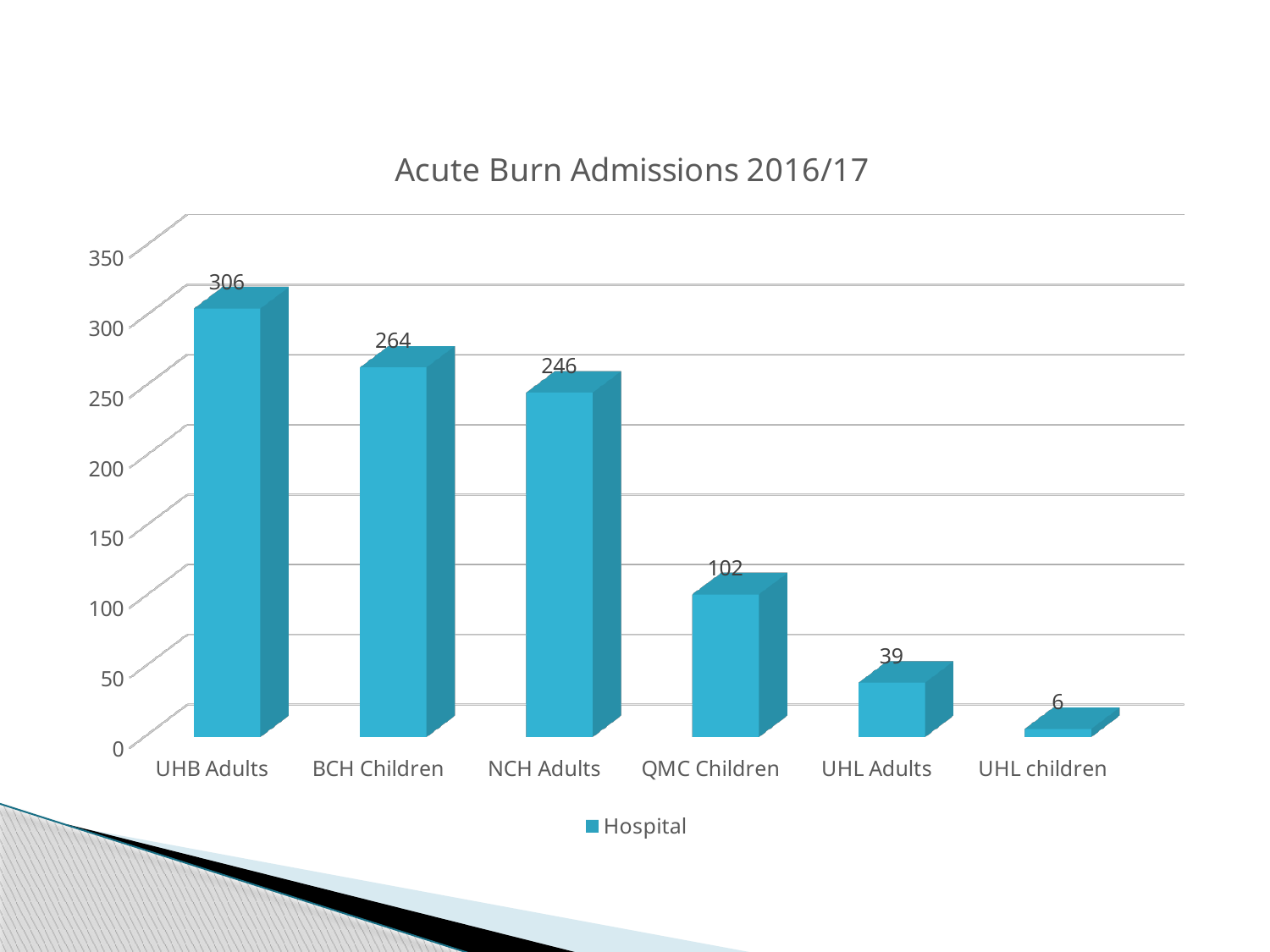
What kind of chart is this? bar chart What is the value for QMC Children? 102 What is the value for UHL children? 6 What is the value for UHB Adults? 306 What is the difference between the values for UHB Adults and BCH Children? 42 Is the value for NCH Adults greater or less than 200? greater Which category has the lowest value? UHL children Which is larger, the value for BCH Children or NCH Adults? BCH Children What is the difference between the values for QMC Children and UHL Adults? 63 How many categories are shown on the x axis? 6 Which category has the highest value? UHB Adults What is the title of the chart? Acute Burn Admissions 2016/17